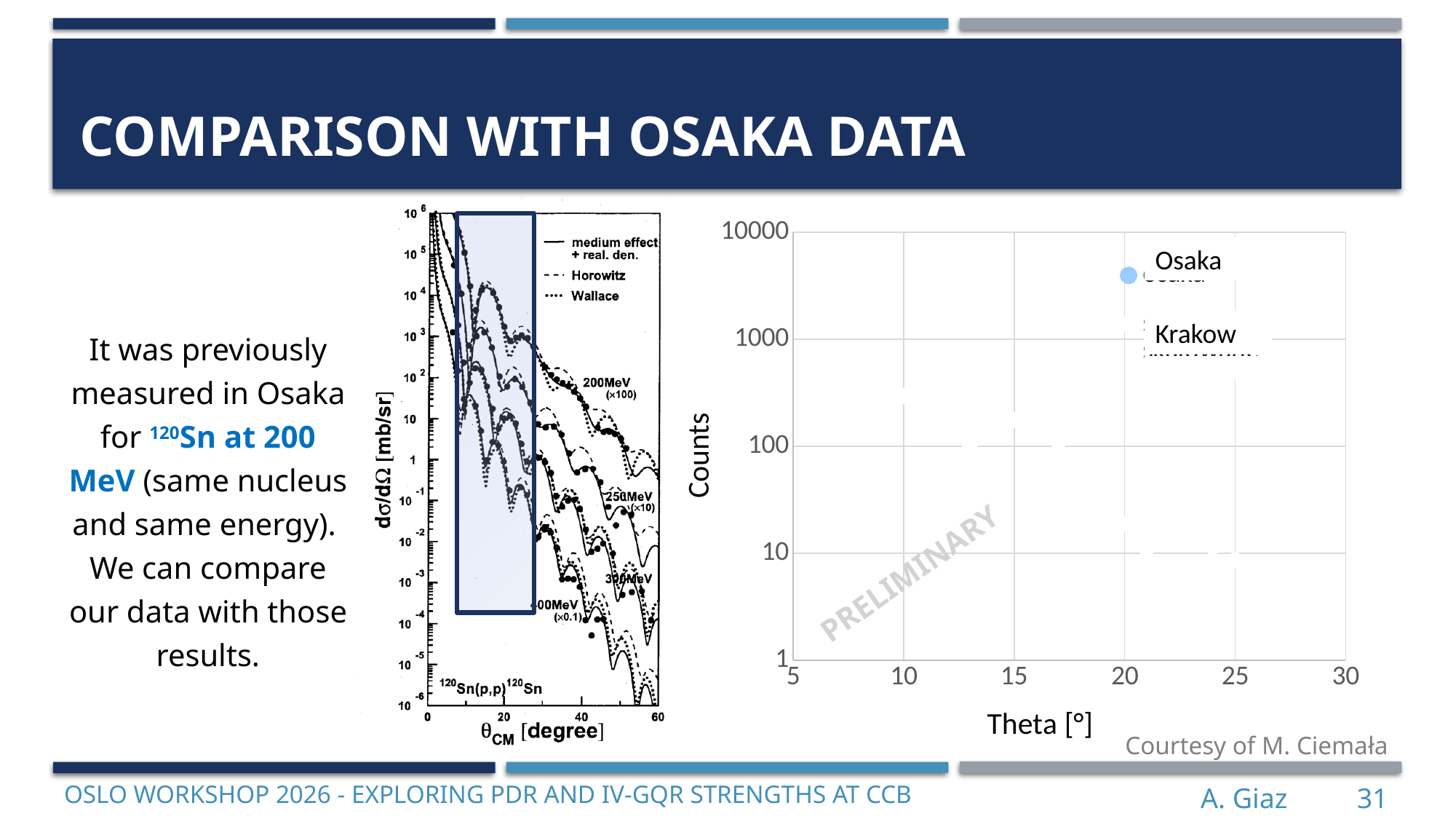
What kind of chart is the left chart (120Sn(p,p)120Sn)? line chart What is the y-axis label of the right chart? Counts On the left chart, which beam energy curve lies lowest on the plot? 400MeV On the right chart, is the Counts value of the Osaka point greater or less than 10000? less What is the x-axis label of the left chart? θCM [degree] On the right chart, is the Counts value of the Osaka point greater or less than 1000? greater On the right chart, is the Theta value of the Osaka point greater or less than 15? greater On the left chart, which beam energy curve lies highest on the plot? 200MeV On the left chart, do the cross-section curves rise or fall as the angle θCM increases? fall How many entries does the legend of the left chart list? 3